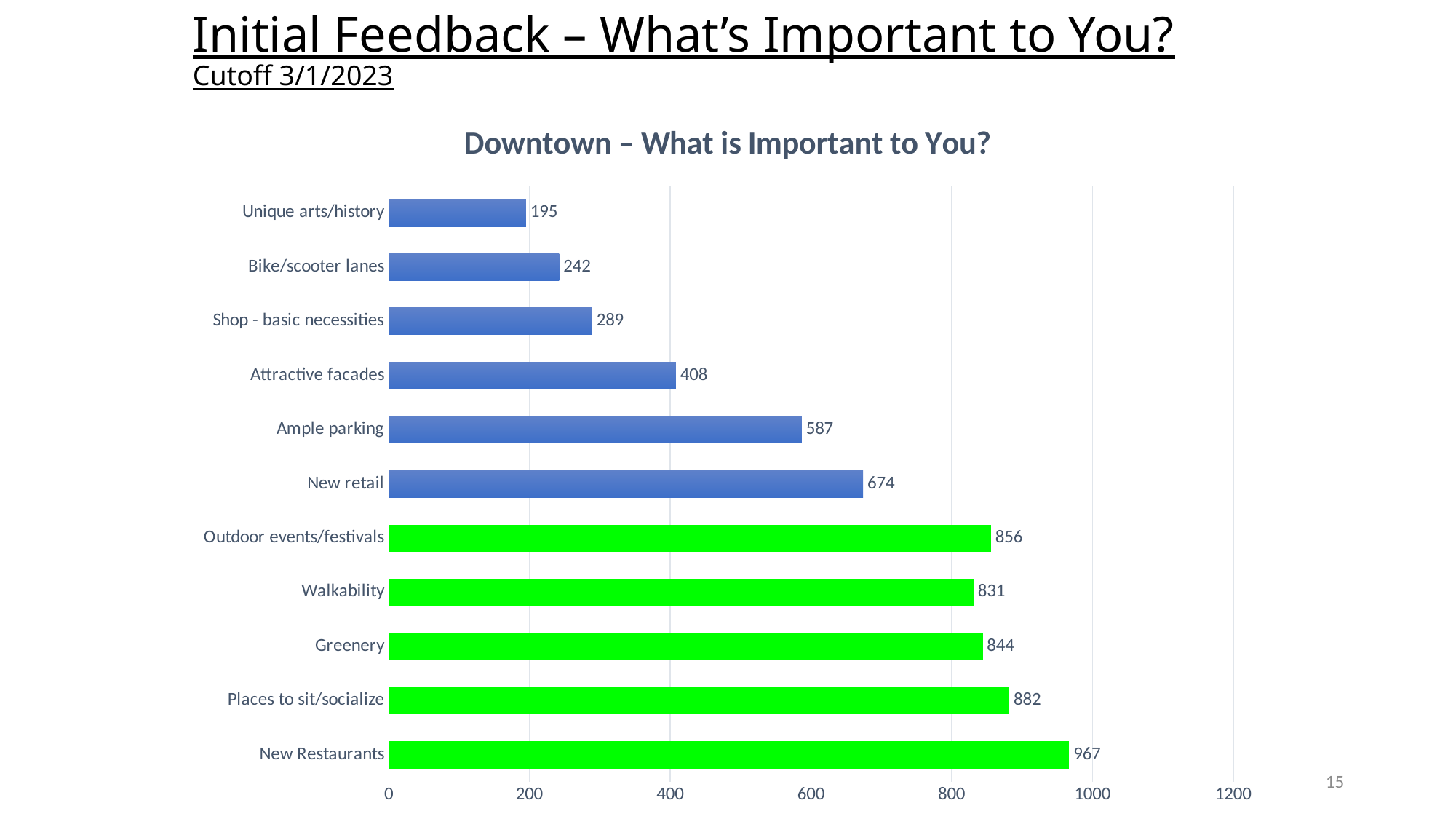
Which is larger, the value for Greenery or the value for Walkability? Greenery Which category has the highest value? New Restaurants How many categories are shown in the chart? 11 What is the difference between the values for New Restaurants and Places to sit/socialize? 85 What is the value for New Restaurants? 967 Which category has the lowest value? Unique arts/history What is the value for Bike/scooter lanes? 242 What is the value for Ample parking? 587 What is the difference between the values for New retail and Ample parking? 87 What is the title of the chart? Downtown – What is Important to You? Which is larger, the value for Attractive facades or the value for Shop - basic necessities? Attractive facades What kind of chart is shown on the slide? Bar chart